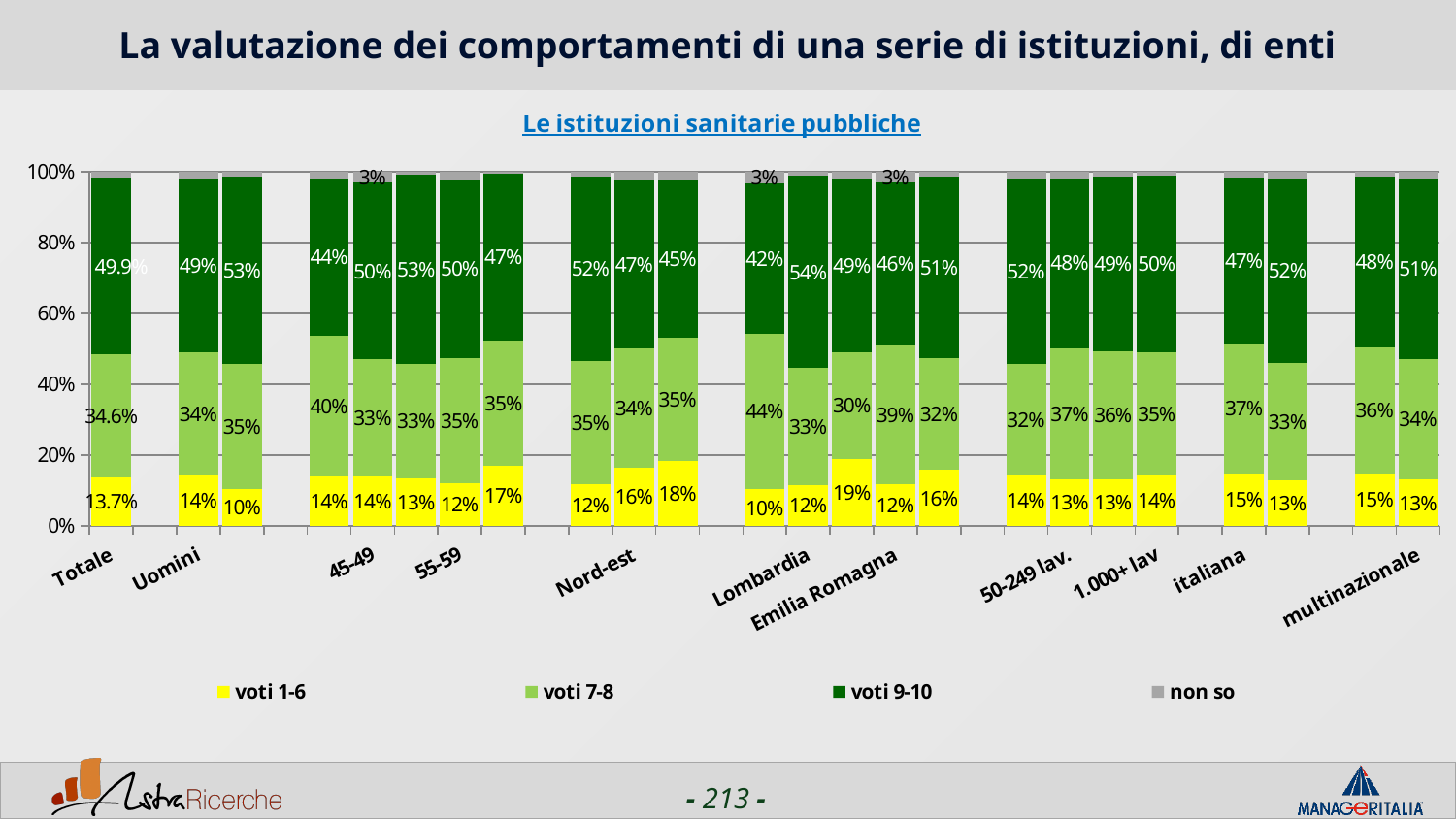
What are the four legend entries of the chart? voti 1-6, voti 7-8, voti 9-10, non so What is the value of 'voti 7-8' for Uomini? 34% What is the value of 'voti 9-10' for Uomini? 49% What kind of chart is shown on the slide? Stacked bar chart What is the value of 'voti 1-6' for Nord-est? 16% What is the value of 'voti 9-10' for Totale? 49.9% What is the value of 'voti 9-10' for Lombardia? 54% For Totale, which is larger: 'voti 7-8' or 'voti 1-6'? voti 7-8 How many series does the legend list? 4 What is the value of 'voti 1-6' for Totale? 13.7% What is the subtitle shown above the chart? Le istituzioni sanitarie pubbliche For Totale, what is the difference between 'voti 9-10' and 'voti 7-8'? 15.3 percentage points